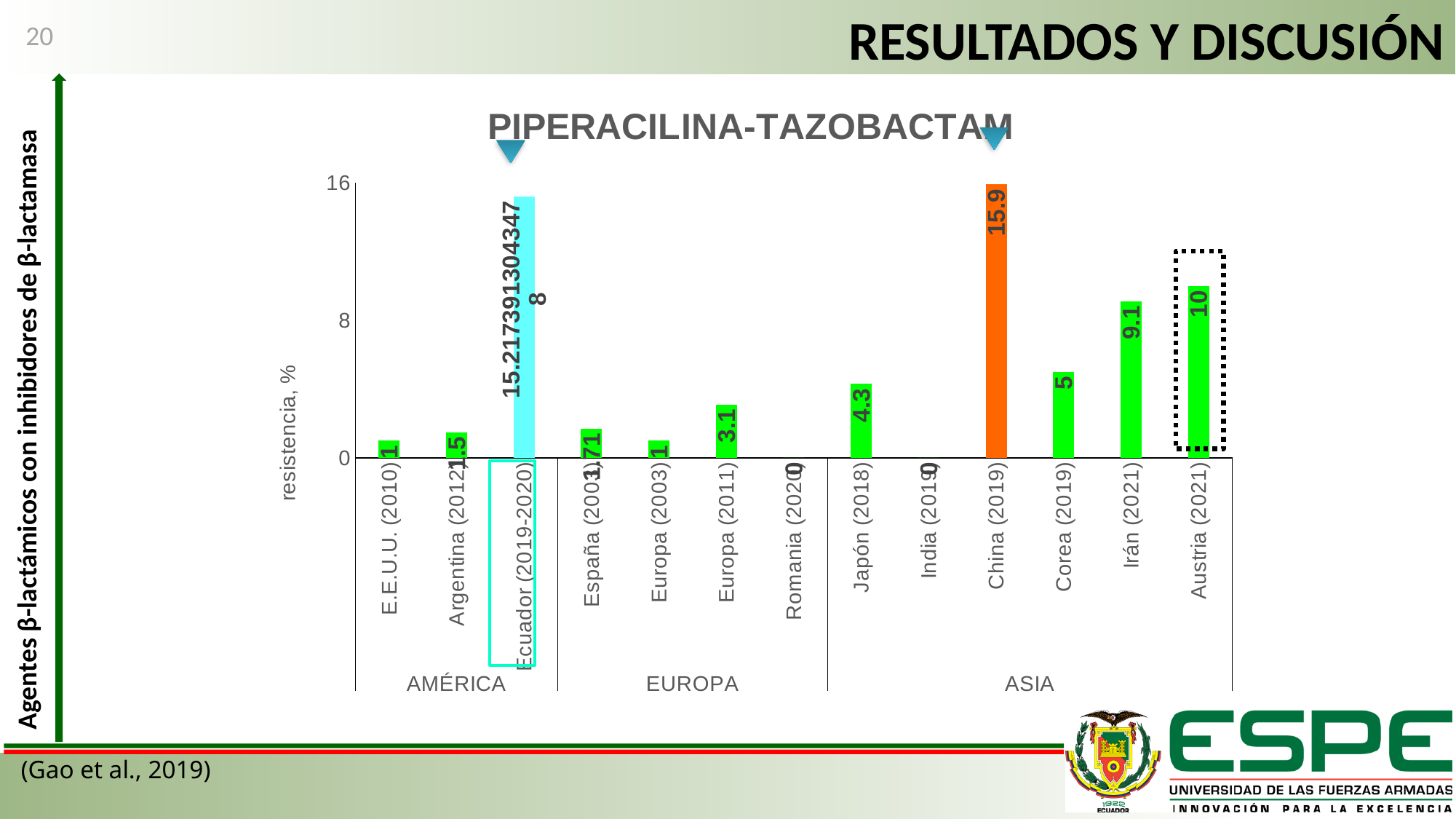
What is the title of the chart? PIPERACILINA-TAZOBACTAM What is the resistance value for Europa (2011)? 3.1 Is the value for Ecuador (2019-2020) greater or less than 8? greater How many categories are plotted on the chart? 13 What is the resistance value for Austria (2021)? 10 What is the difference between the values for Austria (2021) and Irán (2021)? 0.9 What kind of chart is shown on the slide? bar chart Which category has the highest resistance value? China (2019) What is the resistance value for Japón (2018)? 4.3 Which is larger, the value for Corea (2019) or the value for Japón (2018)? Corea (2019) What is the resistance value for China (2019)? 15.9 What is the resistance value for Irán (2021)? 9.1